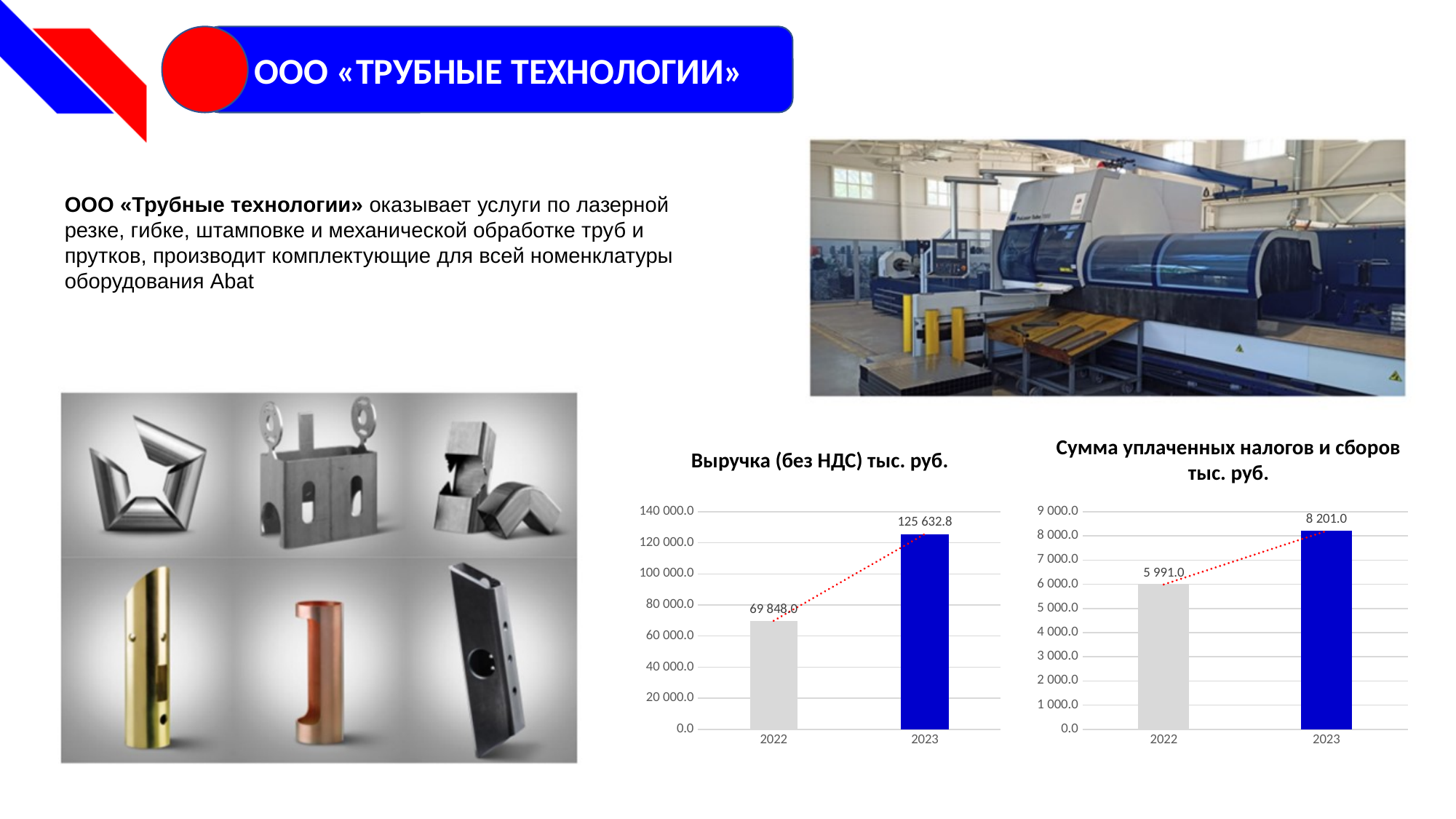
In the chart titled «Сумма уплаченных налогов и сборов тыс. руб.», what is the difference between the 2023 and 2022 values? 2 210.0 In the chart titled «Выручка (без НДС) тыс. руб.», what is the value for 2023? 125 632.8 In the chart titled «Выручка (без НДС) тыс. руб.», which year has the higher value? 2023 In the chart titled «Сумма уплаченных налогов и сборов тыс. руб.», which year has the lower value? 2022 In the chart titled «Сумма уплаченных налогов и сборов тыс. руб.», what is the value for 2023? 8 201.0 In the chart titled «Выручка (без НДС) тыс. руб.», what is the difference between the 2023 and 2022 values? 55 784.8 What kind of chart is the one titled «Выручка (без НДС) тыс. руб.»? bar chart In the chart titled «Выручка (без НДС) тыс. руб.», what is the value for 2022? 69 848.0 In the chart titled «Выручка (без НДС) тыс. руб.», is the value for 2022 greater or less than 80 000.0? less In the chart titled «Сумма уплаченных налогов и сборов тыс. руб.», how many years are shown on the x axis? 2 In the chart titled «Сумма уплаченных налогов и сборов тыс. руб.», do the values rise or fall from 2022 to 2023? rise In the chart titled «Сумма уплаченных налогов и сборов тыс. руб.», what is the value for 2022? 5 991.0